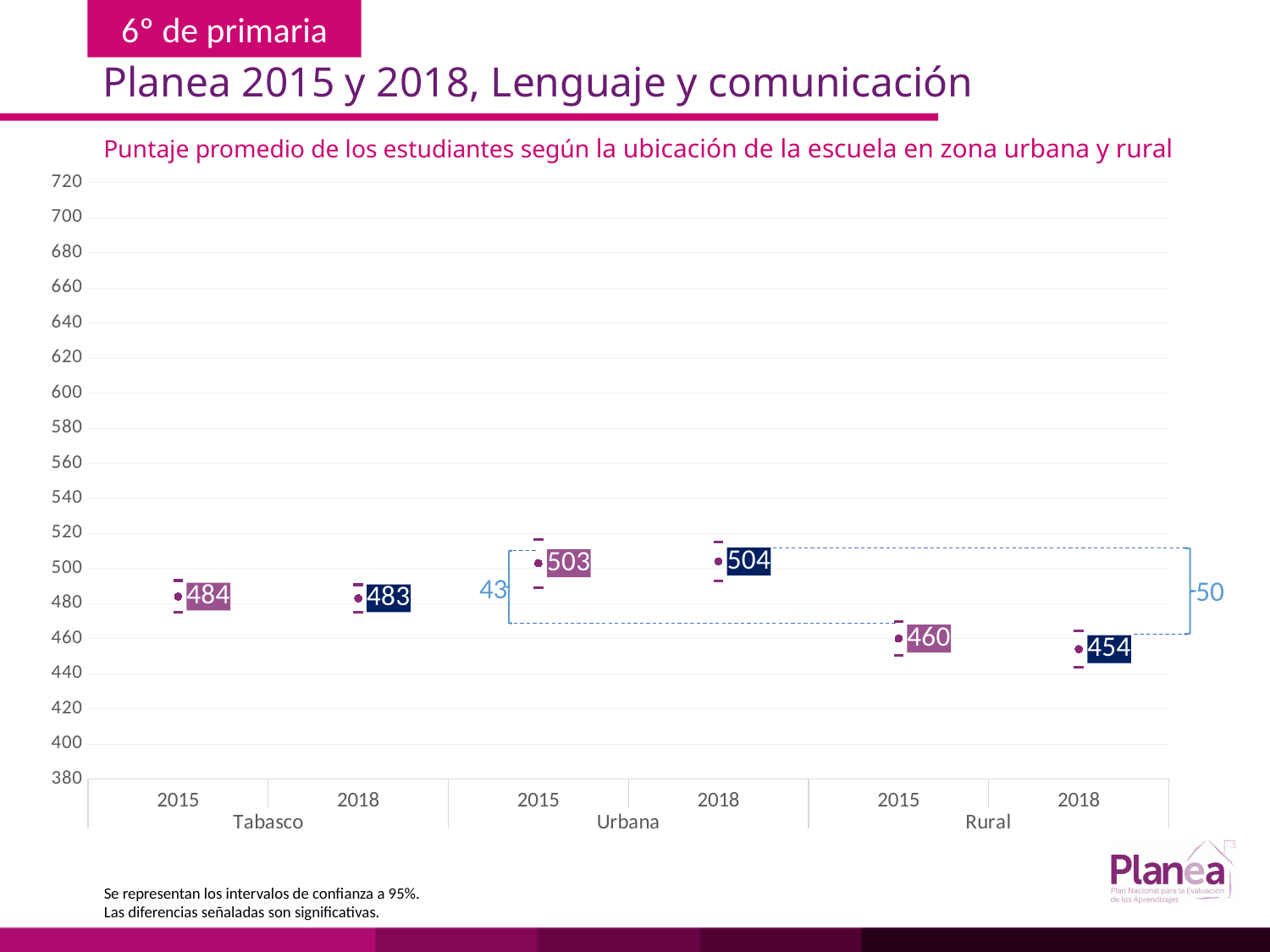
How many data points are plotted on the chart? 6 Which is larger, the Rural score in 2015 or the Rural score in 2018? Rural 2015 What is the difference between the Urbana and Rural scores in 2018? 50 What is the title of the chart? Puntaje promedio de los estudiantes según la ubicación de la escuela en zona urbana y rural What is the average score for Tabasco in 2015? 484 Which group and year has the lowest average score? Rural 2018 What is the difference between the Urbana and Rural scores in 2015? 43 What is the average score for Rural schools in 2018? 454 Did the Rural average score rise or fall from 2015 to 2018? fall Is the Tabasco score for 2018 greater or less than 500? less What is the average score for Urbana schools in 2018? 504 Which group and year has the highest average score? Urbana 2018